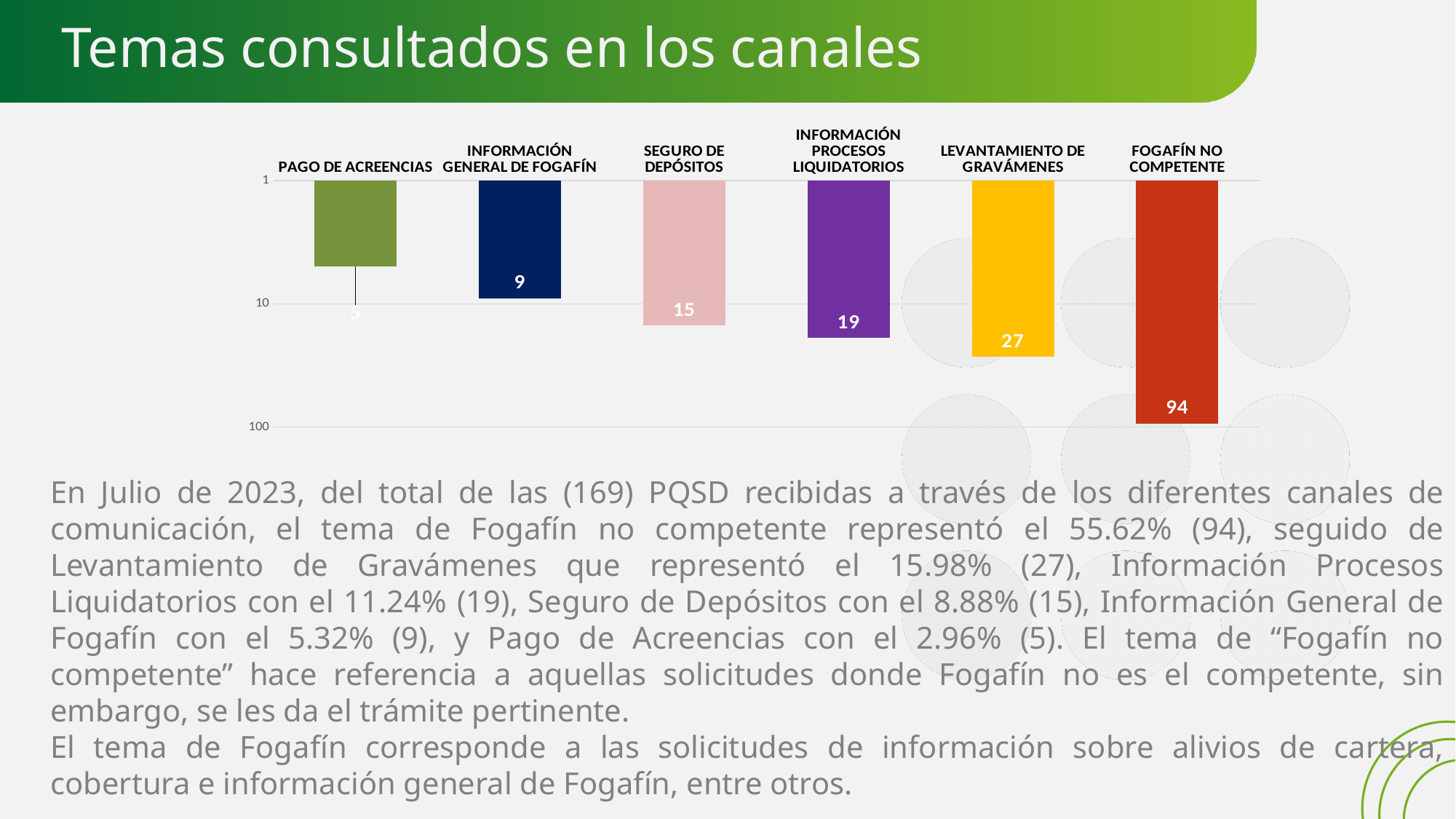
What value is shown for LEVANTAMIENTO DE GRAVÁMENES? 27 What value is shown for SEGURO DE DEPÓSITOS? 15 What value is shown for FOGAFÍN NO COMPETENTE? 94 What kind of chart is shown on the slide? bar chart What is the difference between the values for INFORMACIÓN PROCESOS LIQUIDATORIOS and INFORMACIÓN GENERAL DE FOGAFÍN? 10 How many categories are shown in the chart? 6 What is the difference between the values for FOGAFÍN NO COMPETENTE and LEVANTAMIENTO DE GRAVÁMENES? 67 Which category has the lowest value? PAGO DE ACREENCIAS What value is shown for PAGO DE ACREENCIAS? 5 Which category has the highest value? FOGAFÍN NO COMPETENTE Do the values rise or fall from left to right across the categories? rise Which is larger, the value for SEGURO DE DEPÓSITOS or the value for INFORMACIÓN GENERAL DE FOGAFÍN? SEGURO DE DEPÓSITOS